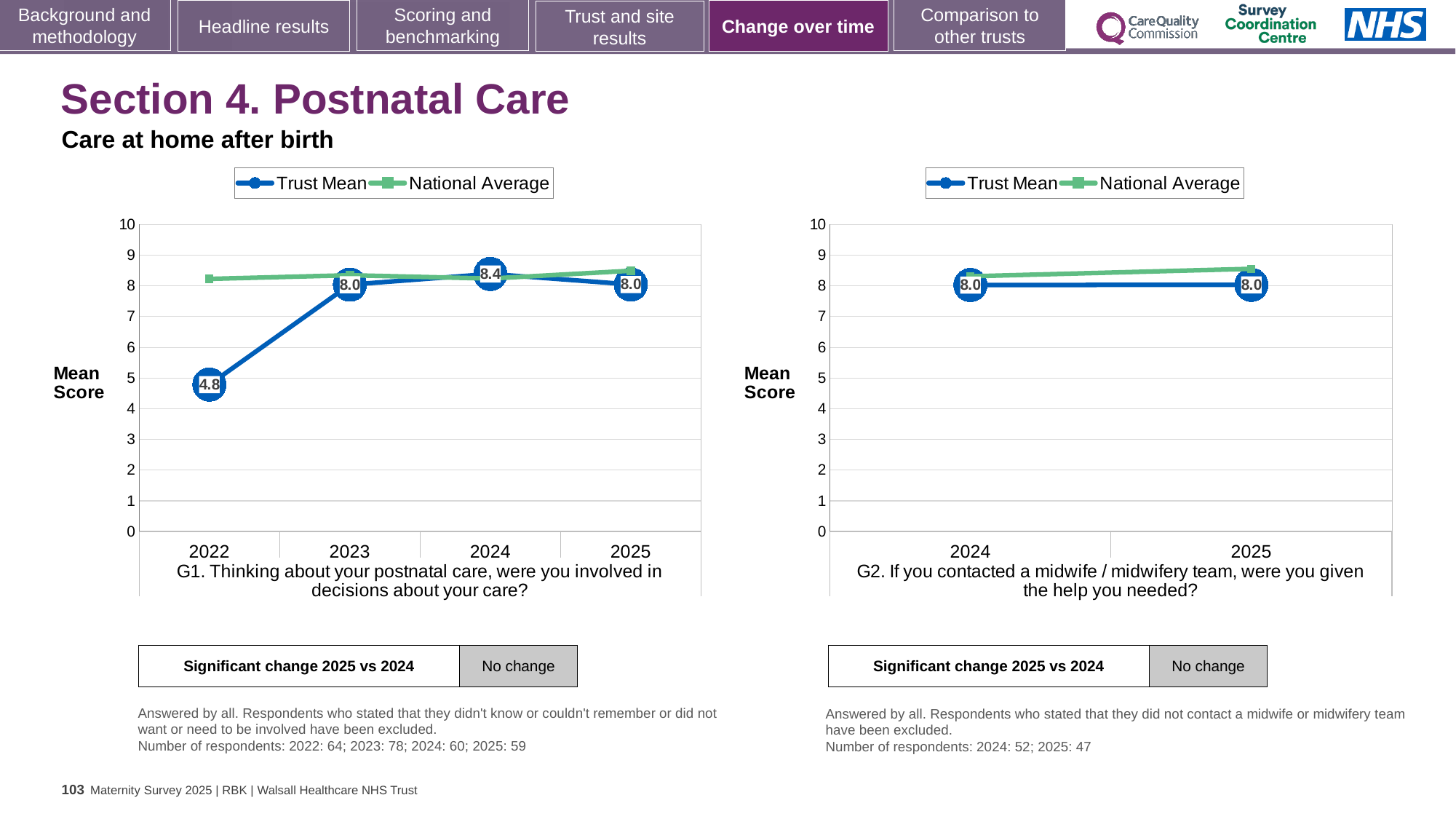
In the G1 chart on the left, which year has the lowest Trust Mean score? 2022 In the G1 chart on the left, what is the Trust Mean score for 2025? 8.0 In the G2 chart on the right, how many series does the legend list? 2 In the G1 chart on the left, is the Trust Mean score for 2022 greater or less than 5? less In the G1 chart on the left, what is the difference between the Trust Mean scores for 2023 and 2022? 3.2 In the G1 chart on the left, what is the Trust Mean score for 2022? 4.8 In the G1 chart on the left, how many years are plotted on the x axis? 4 In the G1 chart on the left, what is the Trust Mean score for 2024? 8.4 What type of chart is the G1 chart on the left? Line chart In the G2 chart on the right, is the National Average for 2025 greater or less than 8? greater In the G2 chart on the right, what is the Trust Mean score for 2025? 8.0 In the G1 chart on the left, which year has the highest Trust Mean score? 2024